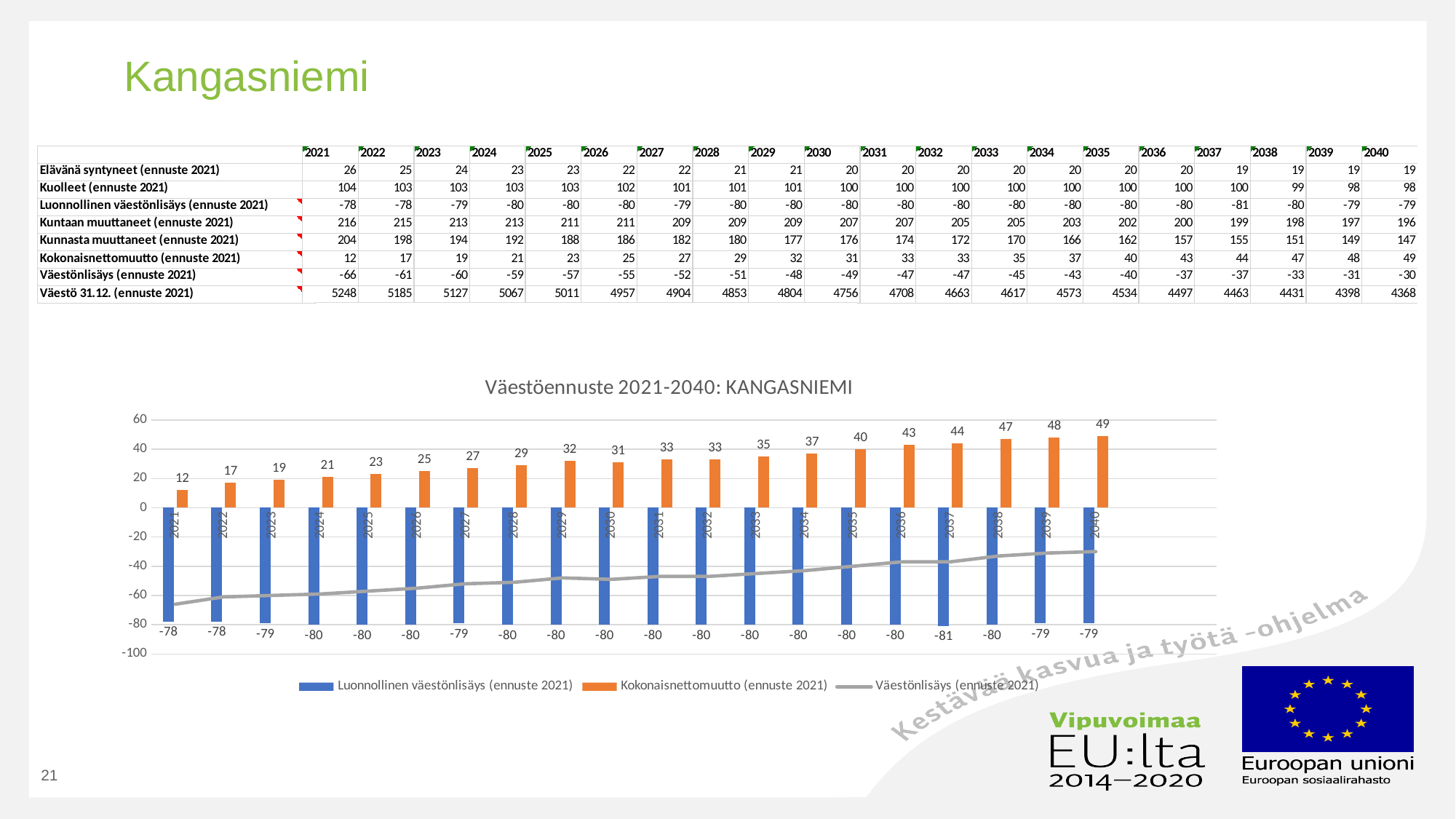
What is the value of Luonnollinen väestönlisäys (ennuste 2021) for 2037 in the chart? -81 Is the Väestönlisäys (ennuste 2021) line value for 2021 greater or less than -60? less Which year has the lowest Kokonaisnettomuutto (ennuste 2021) value in the chart? 2021 Does the Kokonaisnettomuutto (ennuste 2021) series generally rise or fall from 2021 to 2040? rise What kind of chart is used for Luonnollinen väestönlisäys and Kokonaisnettomuutto in the chart? bar chart What is the difference between the Kokonaisnettomuutto (ennuste 2021) values for 2040 and 2021? 37 How many years are shown on the x axis of the chart? 20 Which year has the highest Kokonaisnettomuutto (ennuste 2021) value in the chart? 2040 What is the value of Kokonaisnettomuutto (ennuste 2021) for 2021 in the chart? 12 How many series does the chart legend list? 3 What is the value of Kokonaisnettomuutto (ennuste 2021) for 2040 in the chart? 49 Is the Kokonaisnettomuutto (ennuste 2021) value for 2029 larger or smaller than the value for 2030? larger